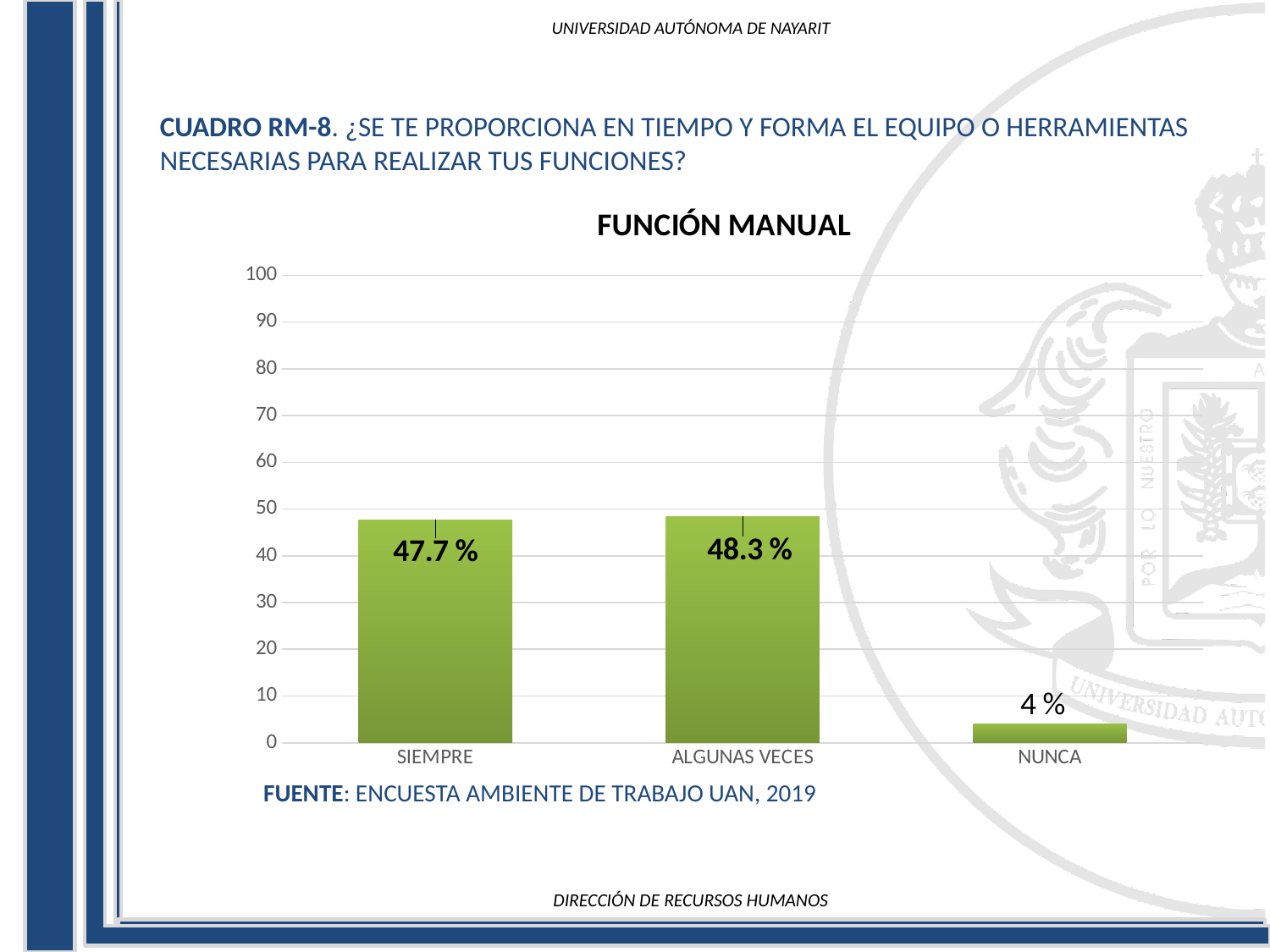
What is the value for NUNCA in the FUNCIÓN MANUAL chart? 4 % Which is larger, the value for SIEMPRE or the value for NUNCA? SIEMPRE Which category has the highest value in the FUNCIÓN MANUAL chart? ALGUNAS VECES What is the difference between the values for SIEMPRE and NUNCA? 43.7 % What is the value for ALGUNAS VECES in the FUNCIÓN MANUAL chart? 48.3 % How many categories are shown in the FUNCIÓN MANUAL chart? 3 Is the value for SIEMPRE greater or less than 50? less What is the title of the chart on the slide? FUNCIÓN MANUAL Which category has the lowest value in the FUNCIÓN MANUAL chart? NUNCA What kind of chart is shown on the slide? bar chart What is the difference between the values for ALGUNAS VECES and SIEMPRE? 0.6 % What is the value for SIEMPRE in the FUNCIÓN MANUAL chart? 47.7 %